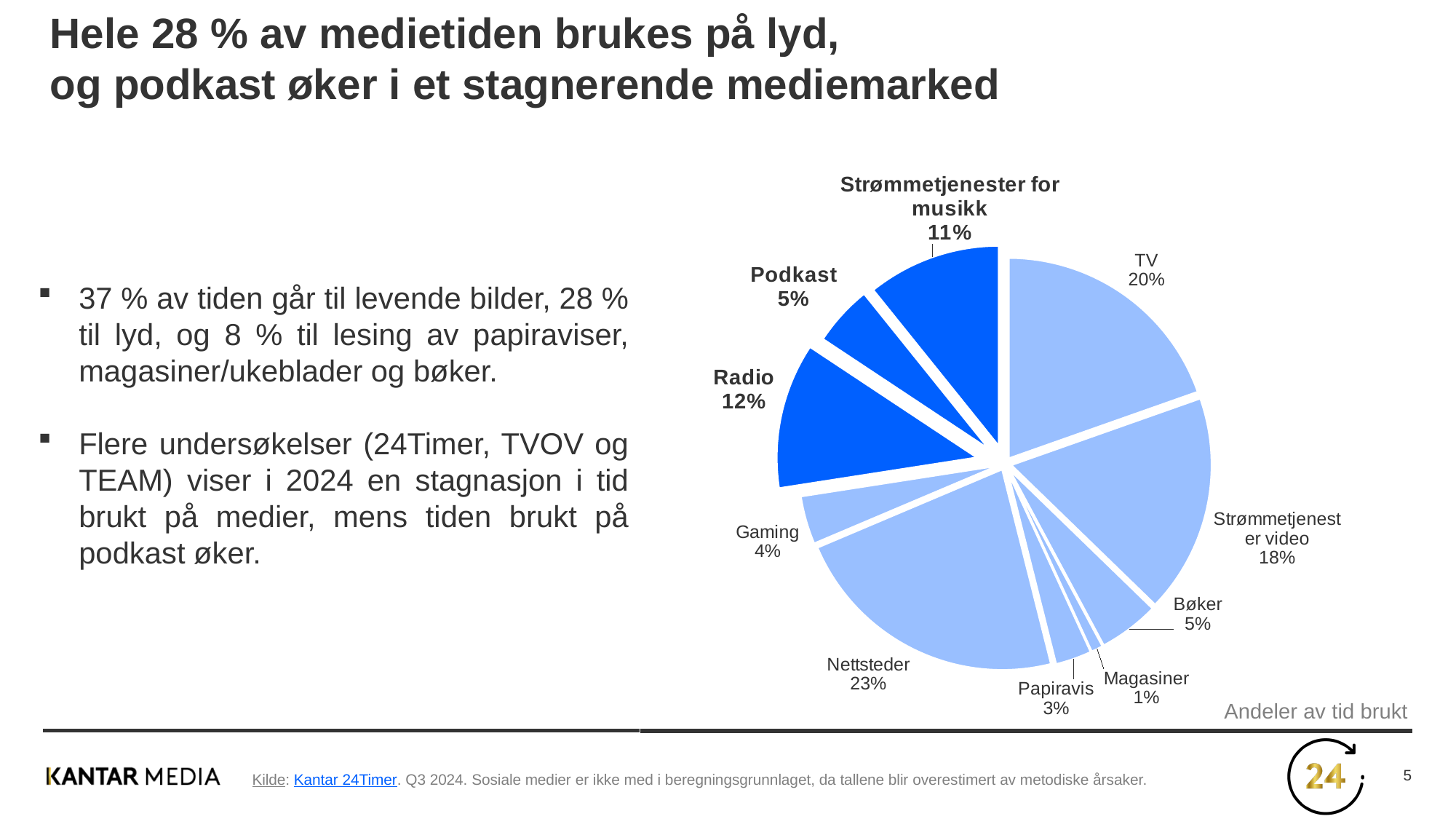
What share of time is spent on Radio? 12% What kind of chart is shown on the slide? pie chart What is the difference in percentage points between TV and Strømmetjenester video? 2 Which category has the smallest share of the pie? Magasiner What share of time is spent on Podkast? 5% Which category has the largest share of the pie? Nettsteder What text appears in the bottom-right corner of the chart describing what the chart shows? Andeler av tid brukt What share of time is spent on Strømmetjenester for musikk? 11% What share of time is spent on Nettsteder? 23% What is the difference in percentage points between Nettsteder and Papiravis? 20 How many categories are shown in the pie chart? 10 Which has a larger share, Radio or Gaming? Radio